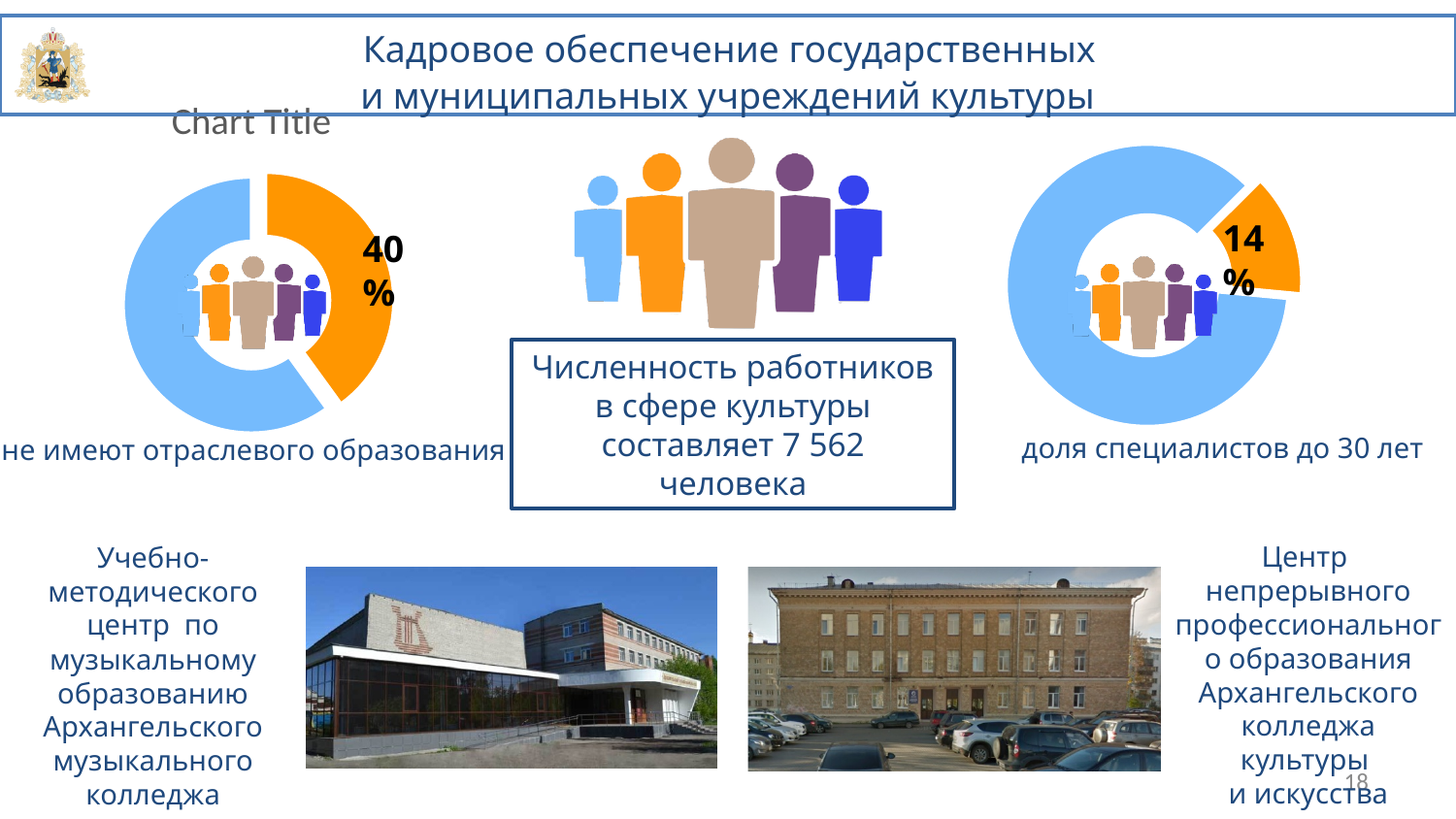
In the right chart ('доля специалистов до 30 лет'), what value is printed on the orange slice? 14% What kind of chart is the left chart labelled 'не имеют отраслевого образования'? Pie (donut) chart In the left chart ('не имеют отраслевого образования'), what value is printed on the orange slice? 40% What kind of chart is the right chart labelled 'доля специалистов до 30 лет'? Pie (donut) chart How many slices does the left chart ('не имеют отраслевого образования') have? 2 How many slices does the right chart ('доля специалистов до 30 лет') have? 2 In the left chart ('не имеют отраслевого образования'), is the blue slice larger or smaller than the orange slice? Larger In the right chart ('доля специалистов до 30 лет'), which slice is the largest? The blue slice What colour is the slice labelled 14% in the right chart ('доля специалистов до 30 лет')? Orange What title is printed above the left chart? Chart Title What is the difference between the orange slice of the left chart (40%) and the orange slice of the right chart (14%)? 26 percentage points Which chart shows the larger orange slice: the left chart ('не имеют отраслевого образования') or the right chart ('доля специалистов до 30 лет')? The left chart